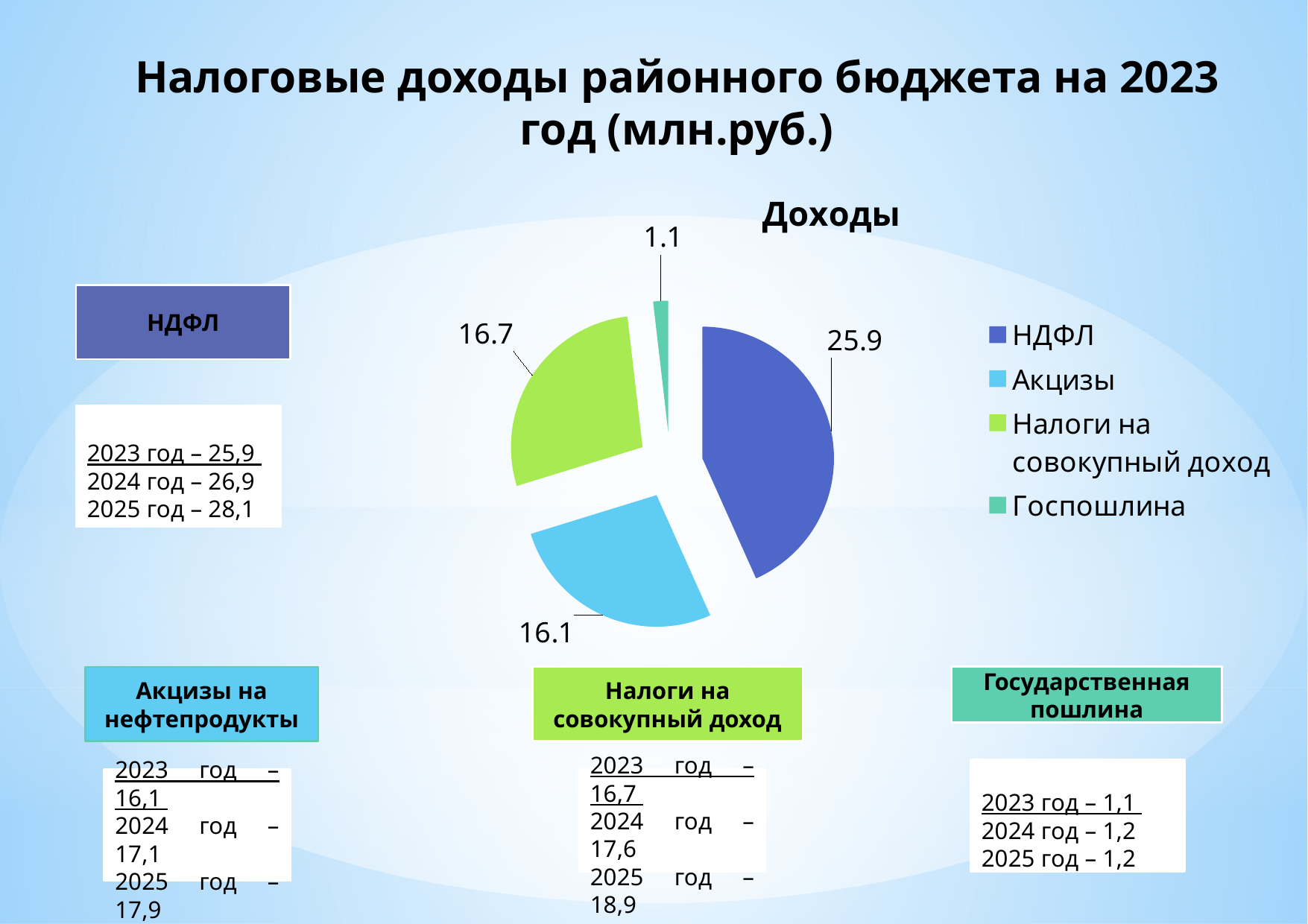
What is the total of all four slices in the pie chart? 59.8 What is the difference between the НДФЛ value and the Налоги на совокупный доход value? 9.2 What is the title of the chart? Доходы What is the value of the Акцизы slice? 16.1 What is the value of the Госпошлина slice? 1.1 What type of chart is shown on the slide? pie chart How many slices does the pie chart have? 4 Which category has the smallest slice in the pie chart? Госпошлина Which is larger, Акцизы or Налоги на совокупный доход? Налоги на совокупный доход What is the value of the НДФЛ slice? 25.9 How many entries does the chart legend list? 4 Which category has the largest slice in the pie chart? НДФЛ